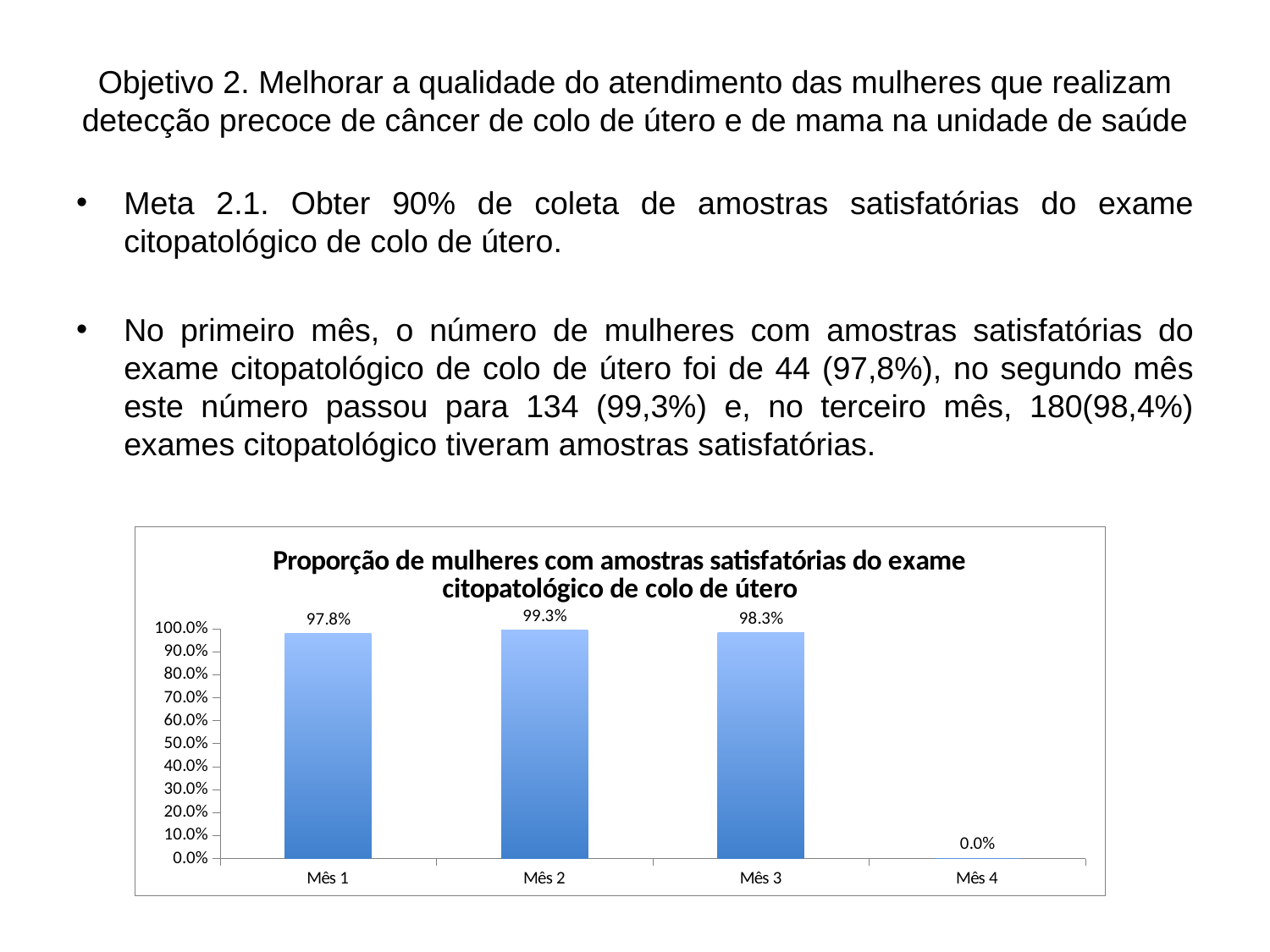
What is the title of the chart? Proporção de mulheres com amostras satisfatórias do exame citopatológico de colo de útero Which is larger, the value for Mês 2 or the value for Mês 3? Mês 2 What is the difference between the values for Mês 2 and Mês 1? 1.5% What is the value for Mês 1? 97.8% Which month has the lowest value? Mês 4 What is the value for Mês 2? 99.3% What is the value for Mês 3? 98.3% How many months are shown on the x axis? 4 What is the value for Mês 4? 0.0% Is the value for Mês 3 greater or less than 90.0%? greater What kind of chart is shown? Bar chart Which month has the highest value? Mês 2